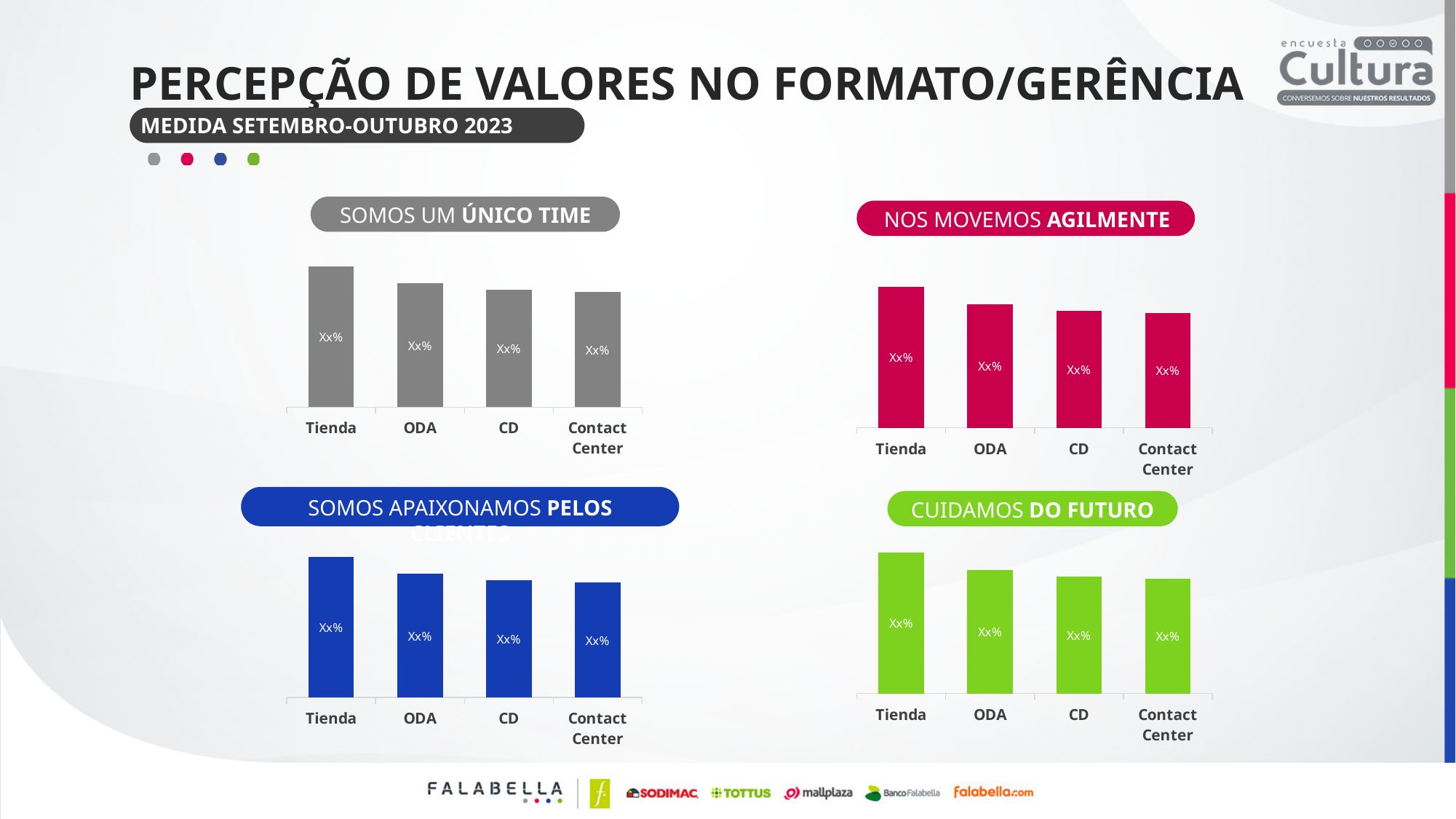
In the "SOMOS APAIXONAMOS PELOS CLIENTES" chart, which bar is taller, Tienda or Contact Center? Tienda In the "CUIDAMOS DO FUTURO" chart, which category has the highest bar? Tienda How many bar charts are on the slide? 4 In the "CUIDAMOS DO FUTURO" chart, which bar is taller, ODA or Contact Center? ODA In the "SOMOS UM ÚNICO TIME" chart, which category has the highest bar? Tienda What kind of chart is used under the heading "SOMOS UM ÚNICO TIME"? bar chart What colour are the bars in the "CUIDAMOS DO FUTURO" chart? green In the "NOS MOVEMOS AGILMENTE" chart, which category has the highest bar? Tienda How many categories are shown in the "NOS MOVEMOS AGILMENTE" chart? 4 In the "NOS MOVEMOS AGILMENTE" chart, do the bars rise or fall from Tienda to Contact Center? fall What is the title of the chart with blue bars? SOMOS APAIXONAMOS PELOS CLIENTES